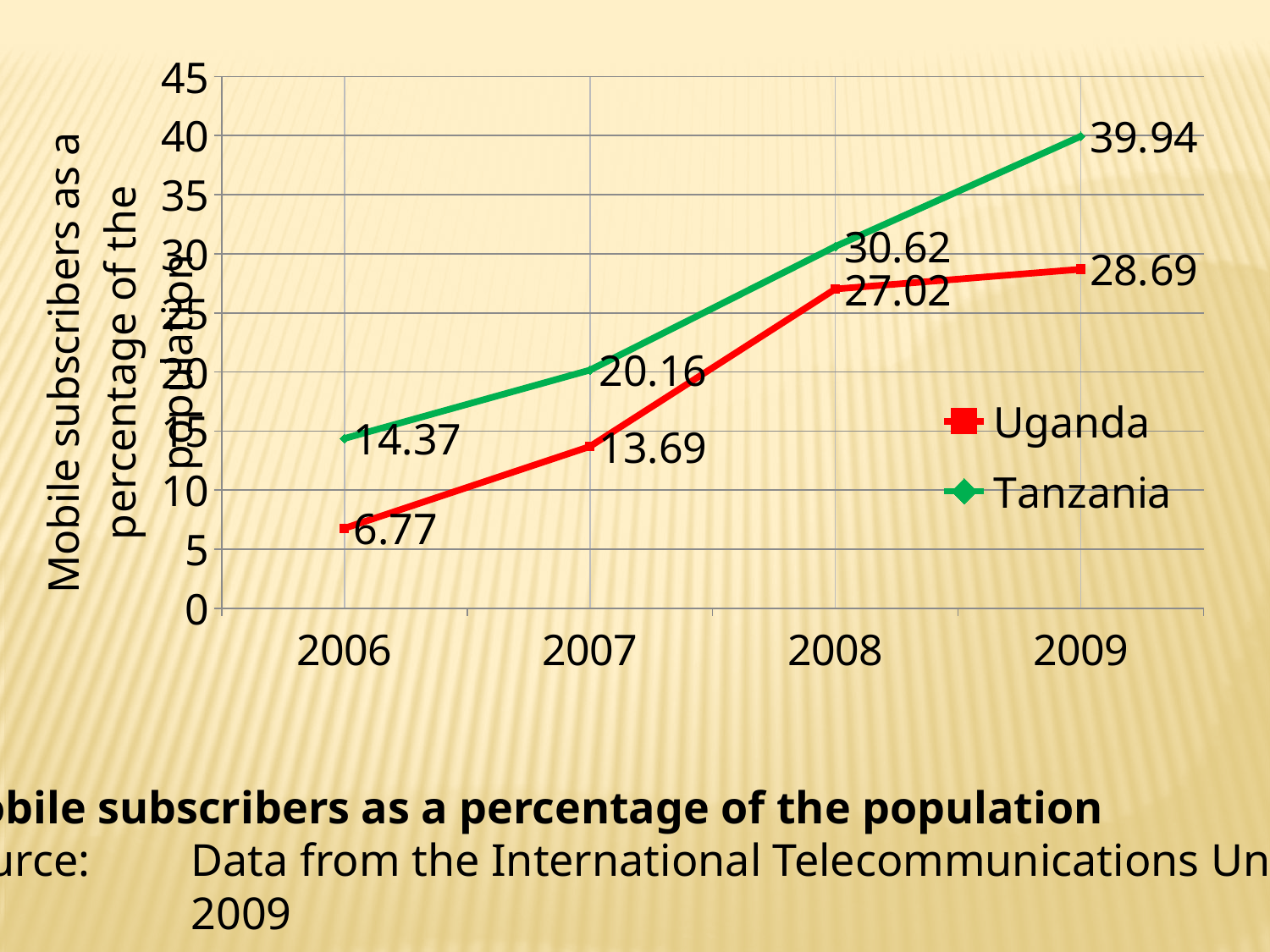
How many series does the legend list? 2 What kind of chart is shown on the slide? line chart In which year was the value for Tanzania highest? 2009 Does the value for Uganda rise or fall from 2006 to 2009? rise What was the value for Tanzania in 2009? 39.94 Which had the larger value in 2006, Uganda or Tanzania? Tanzania What is the difference between the Tanzania and Uganda values in 2009? 11.25 In which year was the value for Uganda lowest? 2006 How many years are shown on the x axis? 4 What was the value for Uganda in 2006? 6.77 What was the value for Uganda in 2008? 27.02 What was the value for Tanzania in 2007? 20.16